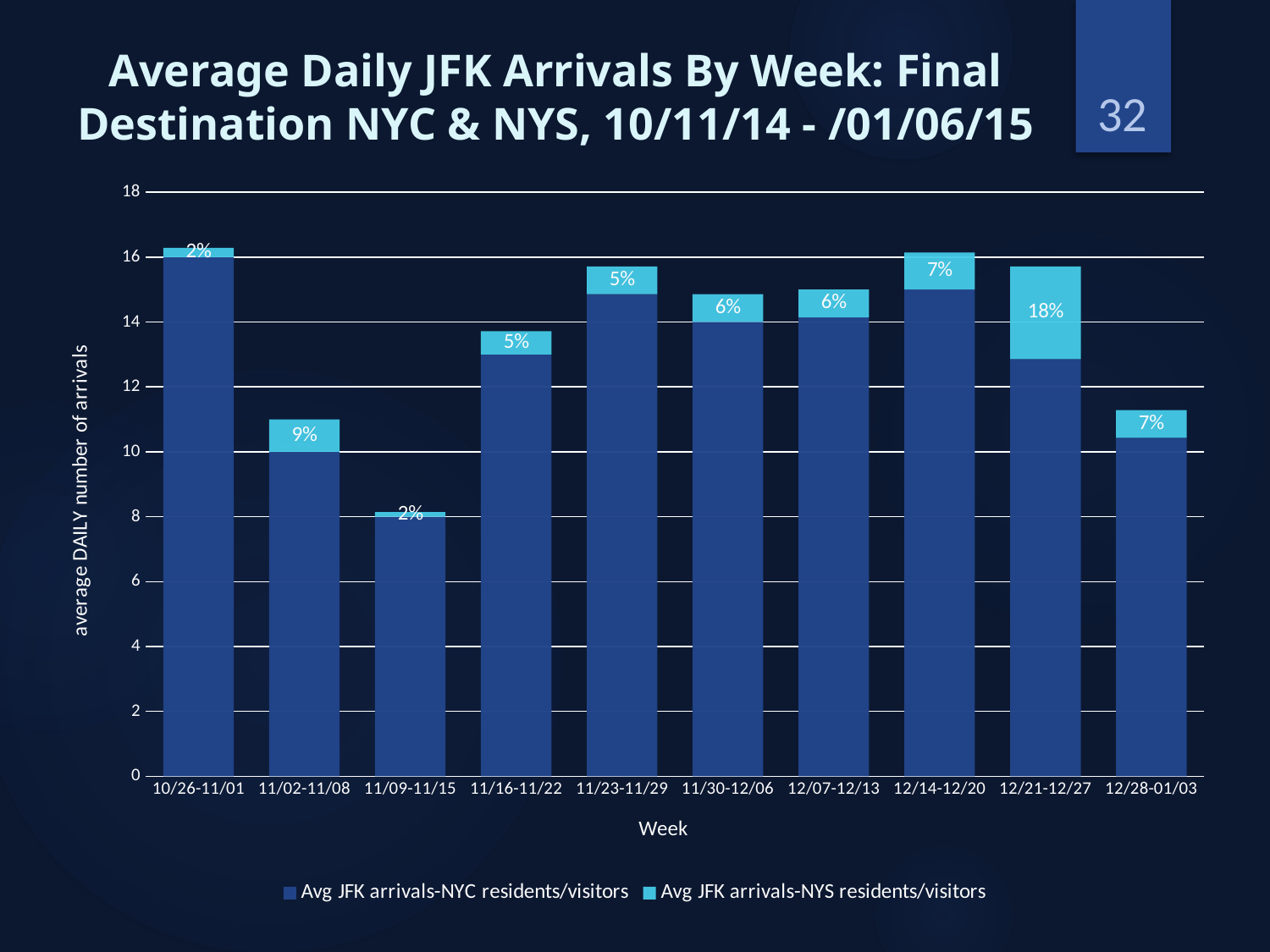
Is the total value for the week 12/21-12/27 greater or less than 14? greater How many series does the legend list? 2 Is the total value for the week 11/09-11/15 greater or less than 10? less What percentage label is shown on the bar for the week 12/21-12/27? 18% What percentage label is shown on the bar for the week 11/02-11/08? 9% Which week has a larger total bar, 11/16-11/22 or 11/23-11/29? 11/23-11/29 Which week has the highest percentage label on its bar? 12/21-12/27 What percentage label is shown on the bar for the week 12/14-12/20? 7% Which week has the lowest total average daily number of arrivals? 11/09-11/15 Is the total value for the week 12/28-01/03 greater or less than 12? less What kind of chart is shown on the slide? Stacked bar chart How many weeks are shown on the x axis? 10